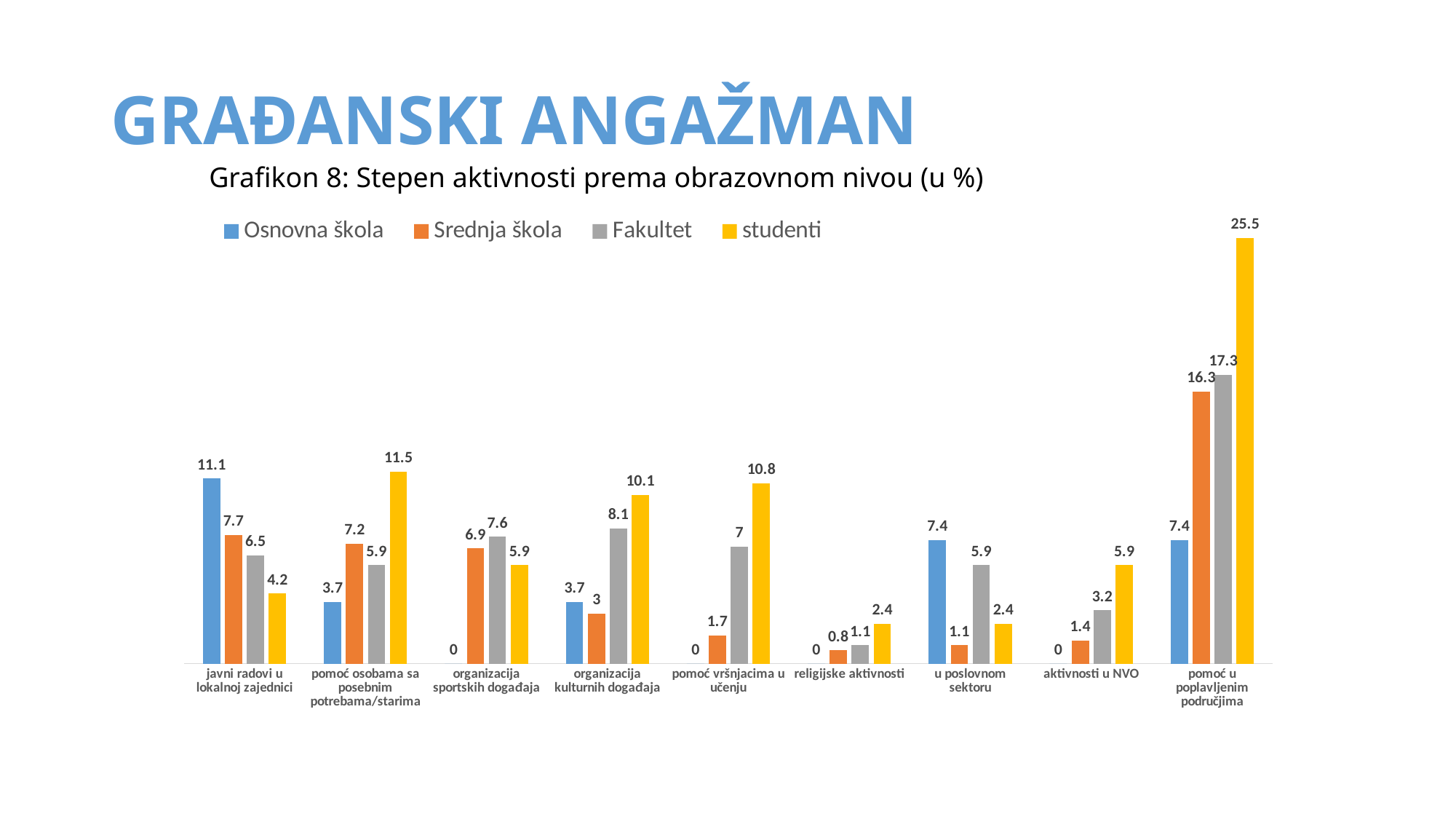
Which is larger in the category 'u poslovnom sektoru': the value for Osnovna škola or the value for Fakultet? Osnovna škola What is the value for studenti in the category 'pomoć u poplavljenim područjima'? 25.5 How many series does the legend list? 4 Which category has the highest value for Srednja škola? pomoć u poplavljenim područjima What is the value for Osnovna škola in the category 'javni radovi u lokalnoj zajednici'? 11.1 What is the value for Srednja škola in the category 'pomoć vršnjacima u učenju'? 1.7 What is the title of the chart? Grafikon 8: Stepen aktivnosti prema obrazovnom nivou (u %) Which category has the lowest value for studenti? religijske aktivnosti and u poslovnom sektoru (both 2.4) What is the value for Fakultet in the category 'organizacija kulturnih događaja'? 8.1 What is the difference between the studenti and Fakultet values in the category 'pomoć u poplavljenim područjima'? 8.2 How many categories are shown on the x axis? 9 What type of chart is shown on the slide? bar chart